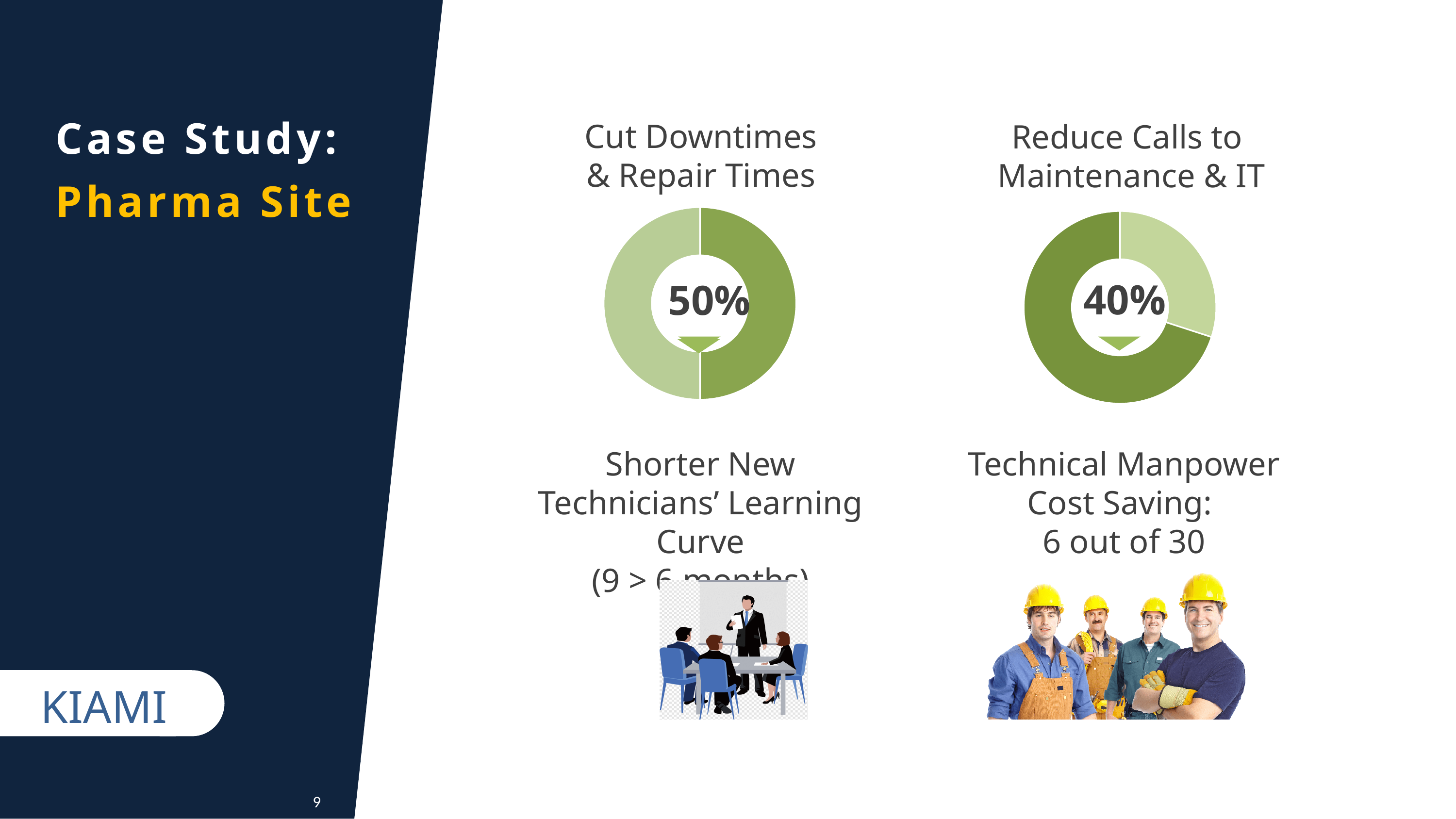
In the "Reduce Calls to Maintenance & IT" chart, is the highlighted value greater or less than 50%? less What is the difference between the percentage in the "Cut Downtimes & Repair Times" chart and the percentage in the "Reduce Calls to Maintenance & IT" chart? 10 percentage points What percentage is shown in the centre of the "Reduce Calls to Maintenance & IT" donut chart? 40% How many slices does the "Cut Downtimes & Repair Times" donut chart have? 2 How many donut charts are shown on the slide? 2 What is the title above the donut chart on the right? Reduce Calls to Maintenance & IT What kind of chart is used under "Cut Downtimes & Repair Times"? Donut chart Which chart shows the larger percentage, "Cut Downtimes & Repair Times" or "Reduce Calls to Maintenance & IT"? Cut Downtimes & Repair Times What is the title above the donut chart on the left? Cut Downtimes & Repair Times How many slices does the "Reduce Calls to Maintenance & IT" donut chart have? 2 What kind of chart is used under "Reduce Calls to Maintenance & IT"? Donut chart What percentage is shown in the centre of the "Cut Downtimes & Repair Times" donut chart? 50%